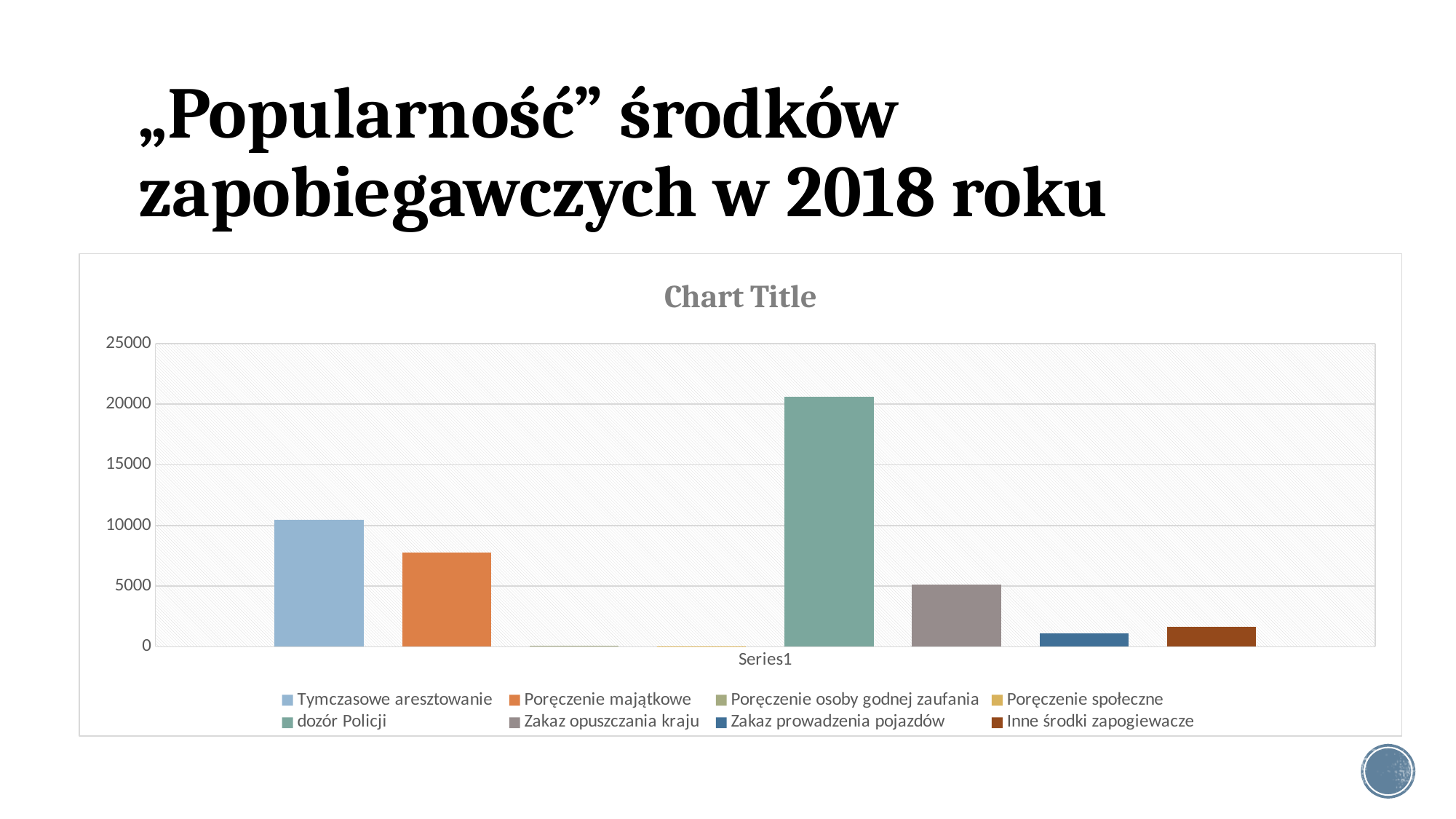
What is the title shown above the chart? Chart Title Which is larger, the value for Tymczasowe aresztowanie or the value for Poręczenie majątkowe? Tymczasowe aresztowanie Which category has the highest value in the chart? dozór Policji Is the value for Inne środki zapogiewacze greater or less than 5000? less Is the value for Tymczasowe aresztowanie greater or less than 10000? greater Is the value for Poręczenie majątkowe greater or less than 10000? less What kind of chart is shown on the slide? bar chart What is the label shown on the x axis below the bars? Series1 How many entries does the chart legend list? 8 Which is larger, the value for Zakaz opuszczania kraju or the value for Zakaz prowadzenia pojazdów? Zakaz opuszczania kraju